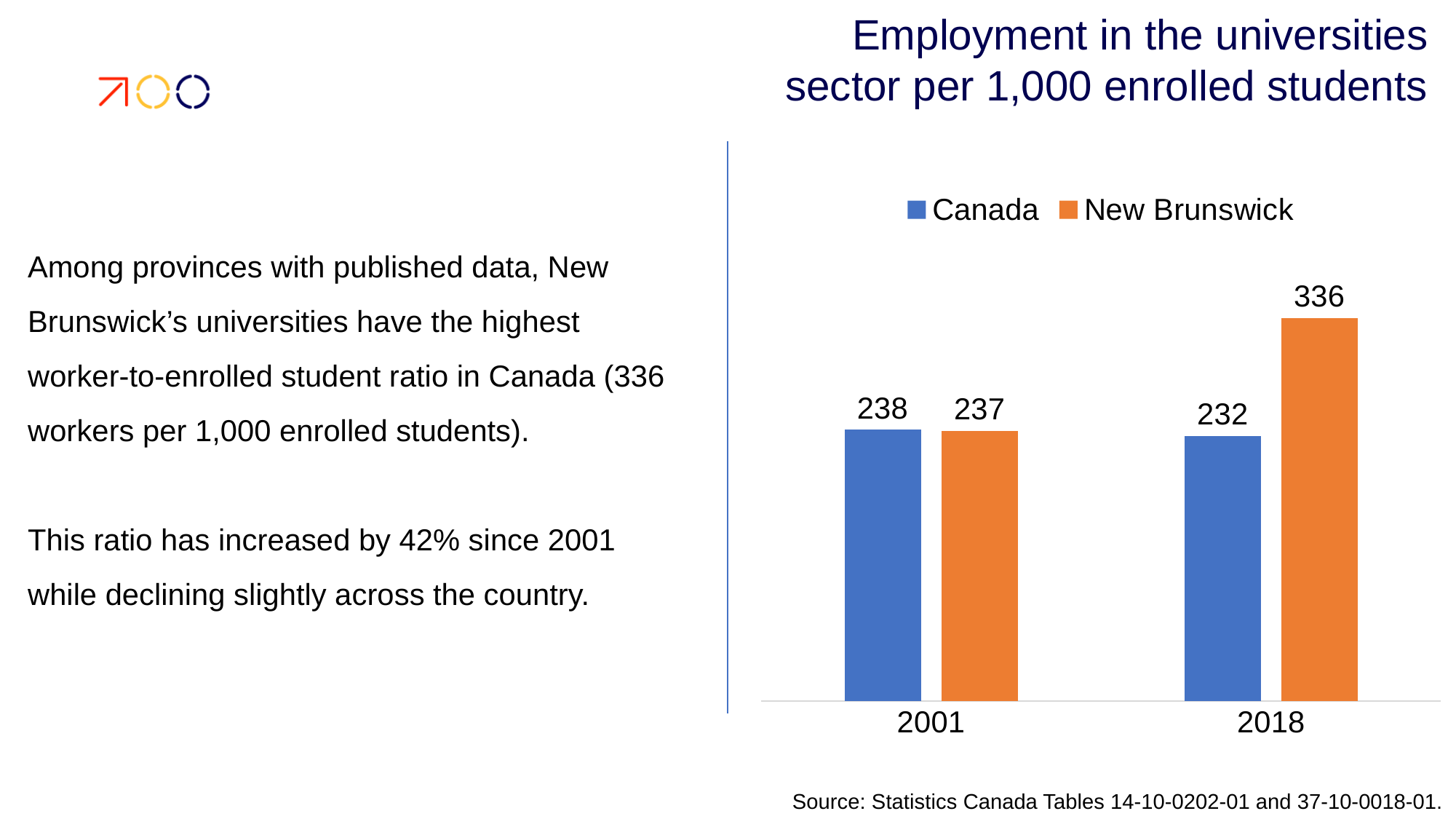
By how much did the New Brunswick value change from 2001 to 2018? 99 Which series has the highest value in 2018? New Brunswick What kind of chart is shown on the slide? Bar chart What is the value for Canada in 2018? 232 What is the difference between New Brunswick and Canada in 2018? 104 What is the value for New Brunswick in 2001? 237 What is the value for Canada in 2001? 238 Which bar has the lowest value on the chart? Canada in 2018 What is the value for New Brunswick in 2018? 336 Does the Canada value rise or fall from 2001 to 2018? Fall How many series does the legend list? 2 Which is larger in 2018, Canada or New Brunswick? New Brunswick